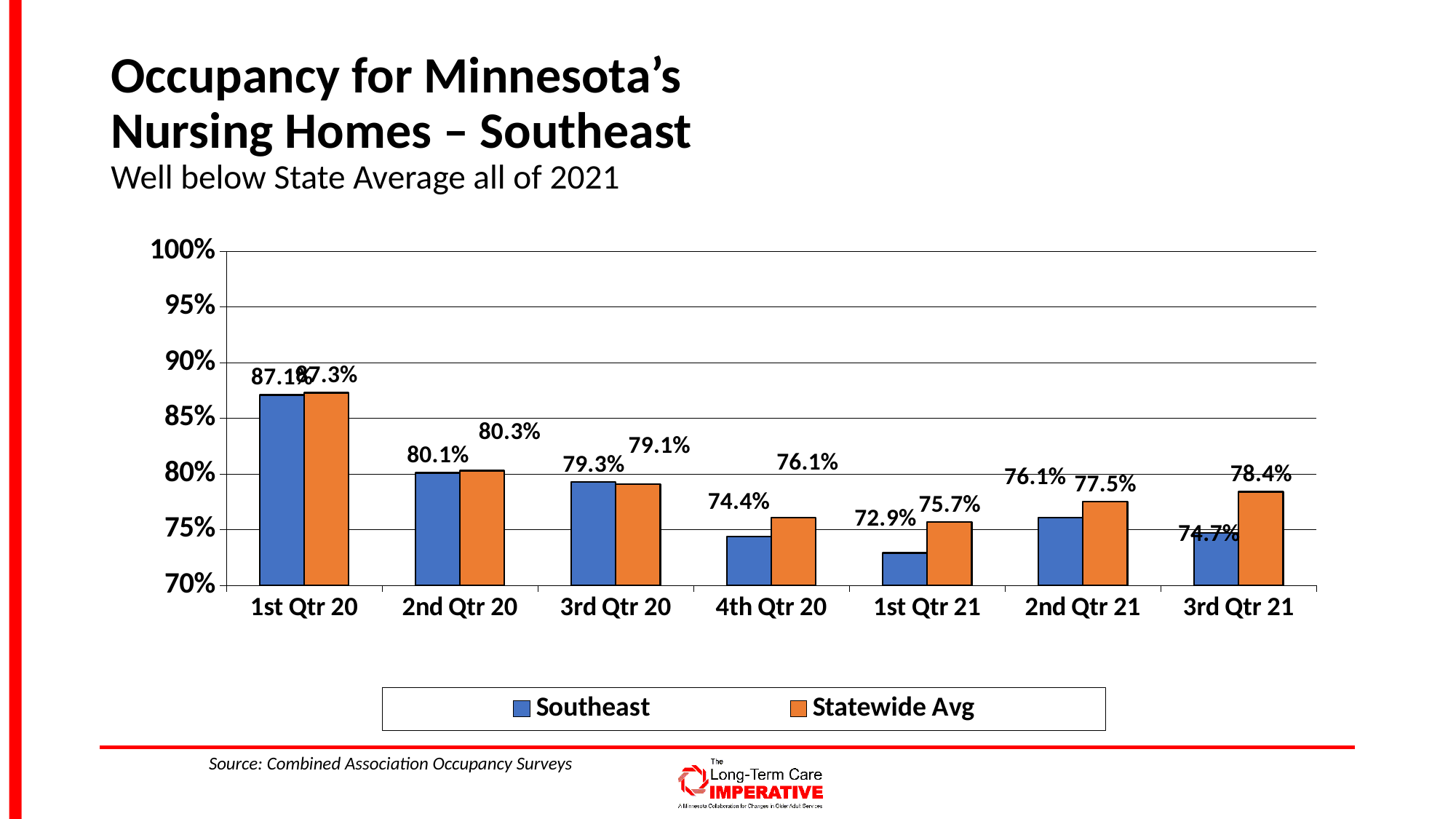
What is the difference between the Statewide Avg and Southeast values in 3rd Qtr 21? 3.7 percentage points How many quarters are shown on the x axis? 7 How many series does the legend list? 2 In which quarter is the Statewide Avg occupancy highest? 1st Qtr 20 What is the Southeast occupancy value for 4th Qtr 20? 74.4% In 3rd Qtr 20, which is larger: the Southeast value or the Statewide Avg value? Southeast In which quarter is the Southeast occupancy lowest? 1st Qtr 21 What kind of chart is shown on the slide? bar chart Is the Southeast value for 2nd Qtr 21 greater or less than 75%? greater What are the two series named in the legend? Southeast and Statewide Avg What is the Southeast occupancy value for 1st Qtr 21? 72.9% What is the Statewide Avg occupancy value for 3rd Qtr 21? 78.4%